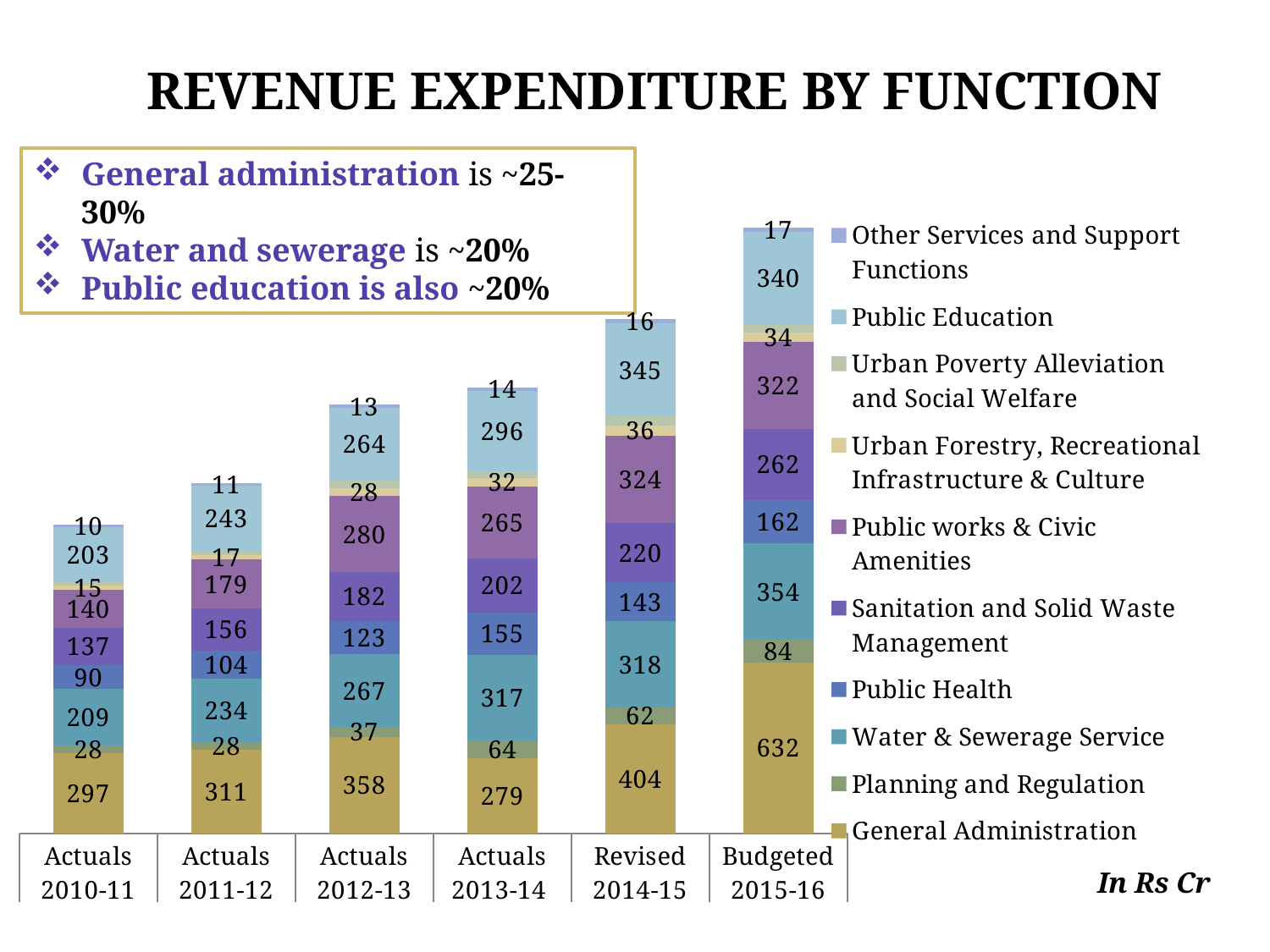
What is the difference between the General Administration values for Budgeted 2015-16 and Revised 2014-15? 228 What kind of chart is shown on the slide? Stacked bar chart In which year is the General Administration value the highest? Budgeted 2015-16 What is the value for Public Education in Actuals 2012-13? 264 Which is larger, the Public works & Civic Amenities value for Actuals 2012-13 or for Actuals 2013-14? Actuals 2012-13 In which year is the General Administration value the lowest? Actuals 2013-14 What is the value for Water & Sewerage Service in Revised 2014-15? 318 What is the value for Sanitation and Solid Waste Management in Actuals 2013-14? 202 How many years (categories) are shown on the x axis? 6 How many series does the legend list? 10 What is the difference between the Water & Sewerage Service values for Budgeted 2015-16 and Revised 2014-15? 36 What is the value for General Administration in Budgeted 2015-16? 632